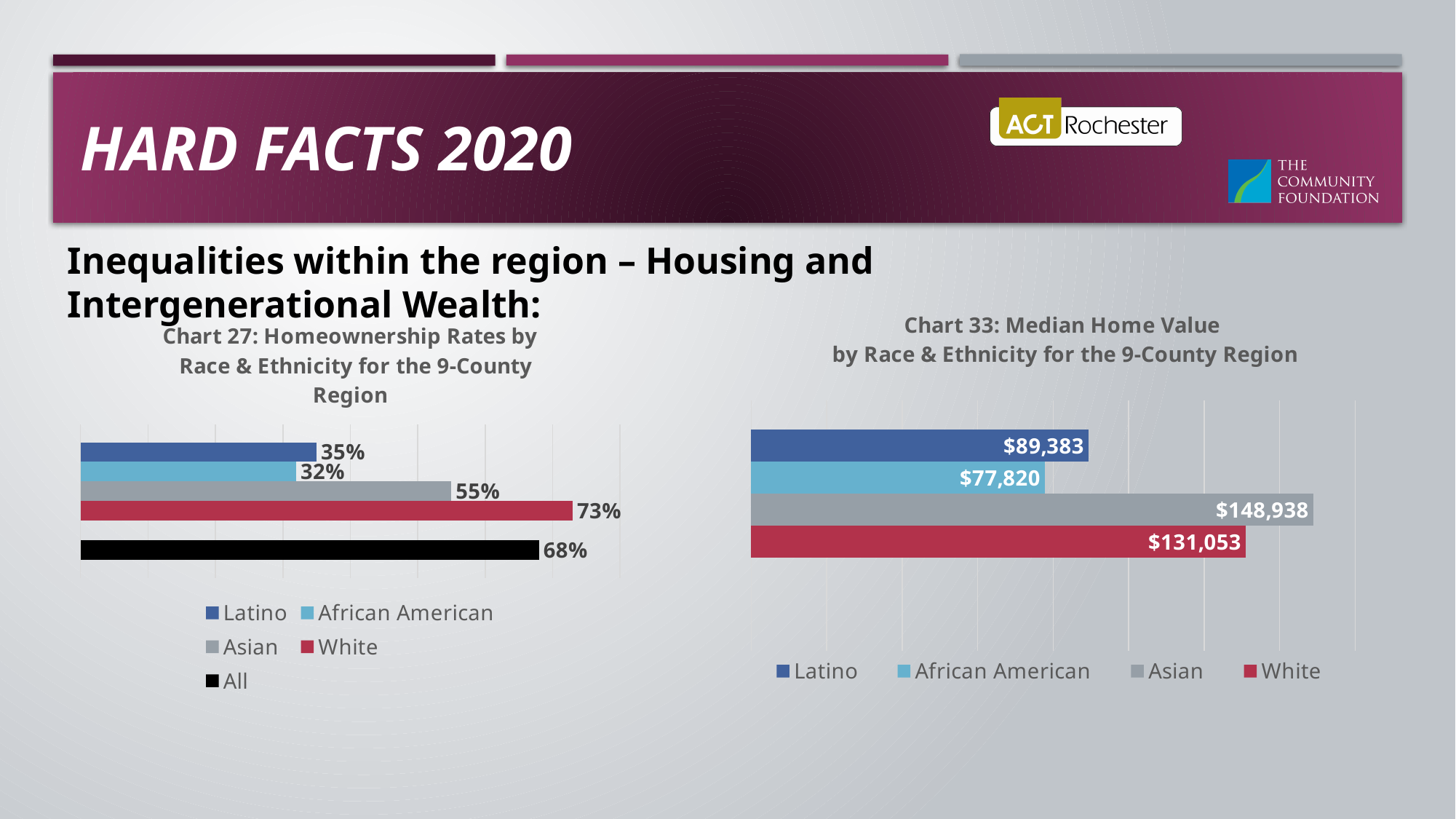
In Chart 33: Median Home Value by Race & Ethnicity for the 9-County Region, which group has the highest median home value? Asian What kind of chart is Chart 33: Median Home Value by Race & Ethnicity for the 9-County Region? Bar chart In Chart 27: Homeownership Rates by Race & Ethnicity for the 9-County Region, how many series does the legend list? 5 In Chart 33: Median Home Value by Race & Ethnicity for the 9-County Region, what is the median home value for African American? $77,820 In Chart 27: Homeownership Rates by Race & Ethnicity for the 9-County Region, which group has the highest homeownership rate? White In Chart 27: Homeownership Rates by Race & Ethnicity for the 9-County Region, what is the difference between the White and Asian homeownership rates? 18% In Chart 33: Median Home Value by Race & Ethnicity for the 9-County Region, what is the median home value for Asian? $148,938 In Chart 27: Homeownership Rates by Race & Ethnicity for the 9-County Region, what is the homeownership rate for All? 68% In Chart 27: Homeownership Rates by Race & Ethnicity for the 9-County Region, which group has the lowest homeownership rate? African American In Chart 27: Homeownership Rates by Race & Ethnicity for the 9-County Region, what is the homeownership rate for Latino? 35% In Chart 33: Median Home Value by Race & Ethnicity for the 9-County Region, which is larger, the median home value for Latino or for African American? Latino In Chart 33: Median Home Value by Race & Ethnicity for the 9-County Region, what is the difference between the Asian and White median home values? $17,885